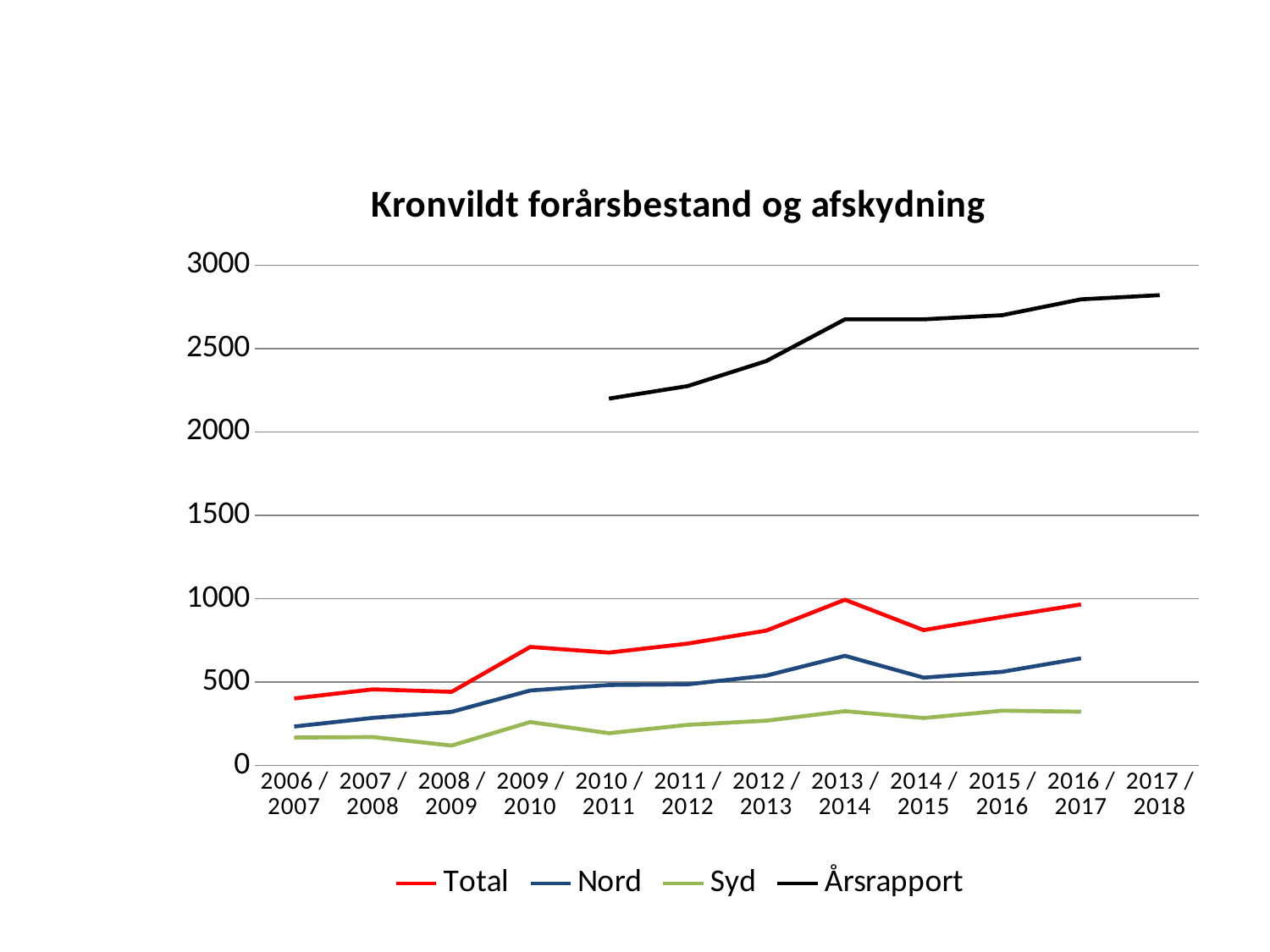
Is the value for Årsrapport in 2013 / 2014 greater or less than 2500? greater Does the Årsrapport series rise or fall from 2010 / 2011 to 2017 / 2018? rise How many series does the legend list? 4 How many seasons are shown on the x axis? 12 Which series has the highest values overall? Årsrapport In 2016 / 2017, which is larger, Nord or Syd? Nord Is the value for Total in 2006 / 2007 greater or less than 500? less What kind of chart is shown on the slide? line chart Is the value for Total in 2009 / 2010 greater or less than 500? greater Which series is the only one with a value plotted for 2017 / 2018? Årsrapport In which season does the Syd series reach its lowest value? 2008 / 2009